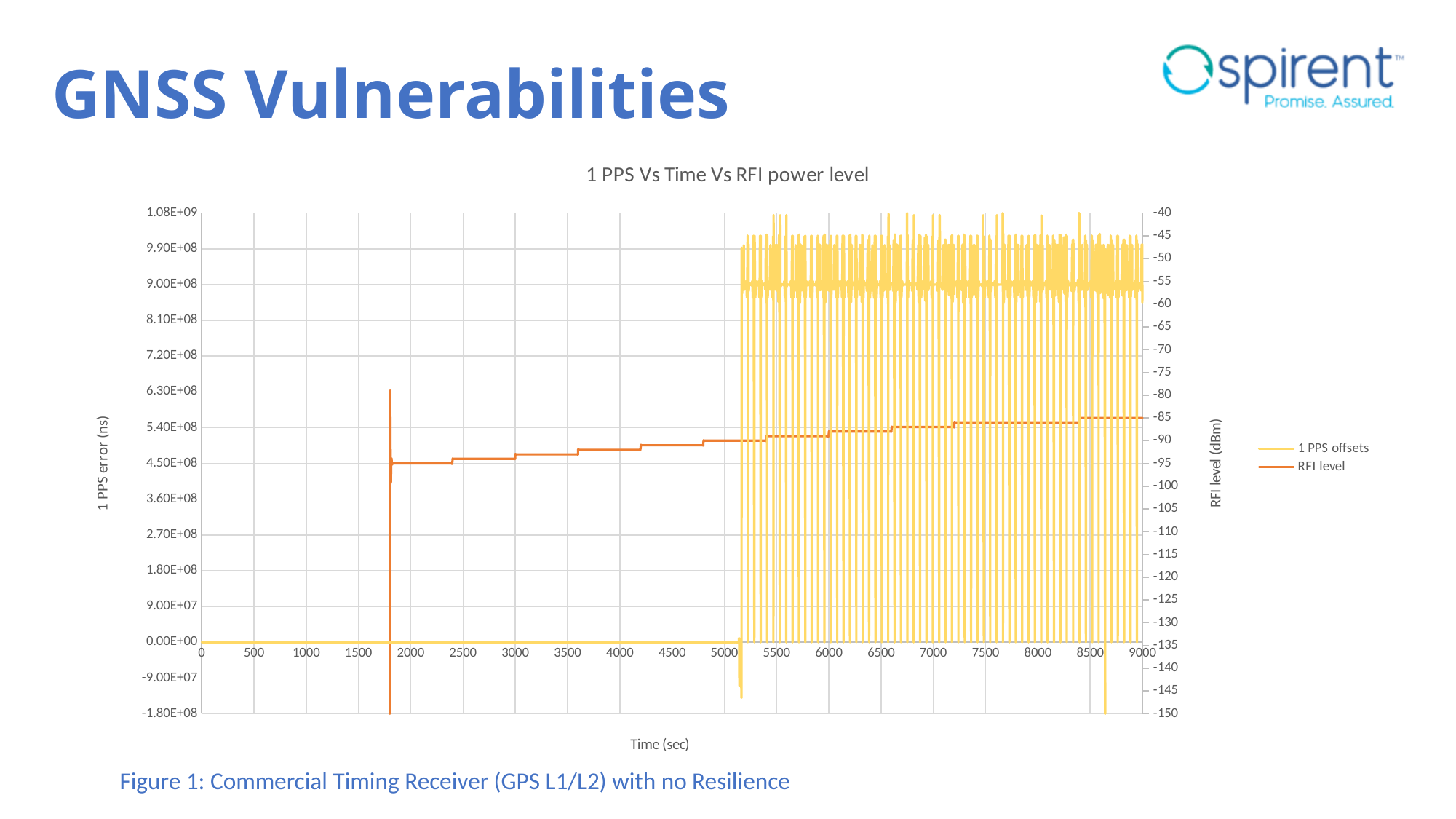
Which series is drawn in orange according to the legend? RFI level Does the RFI level rise or fall as time increases from 2000 to 9000 sec? rise Is the RFI level at time 2000 sec greater or less than -80? less What is the title of the chart? 1 PPS Vs Time Vs RFI power level Is the RFI level at time 8000 sec greater or less than -100? greater Is the RFI level at time 8500 sec greater or less than -70? less What kind of chart is shown on the slide? line chart Is the RFI level higher at time 8000 sec or at time 2500 sec? 8000 sec How many series does the legend list? 2